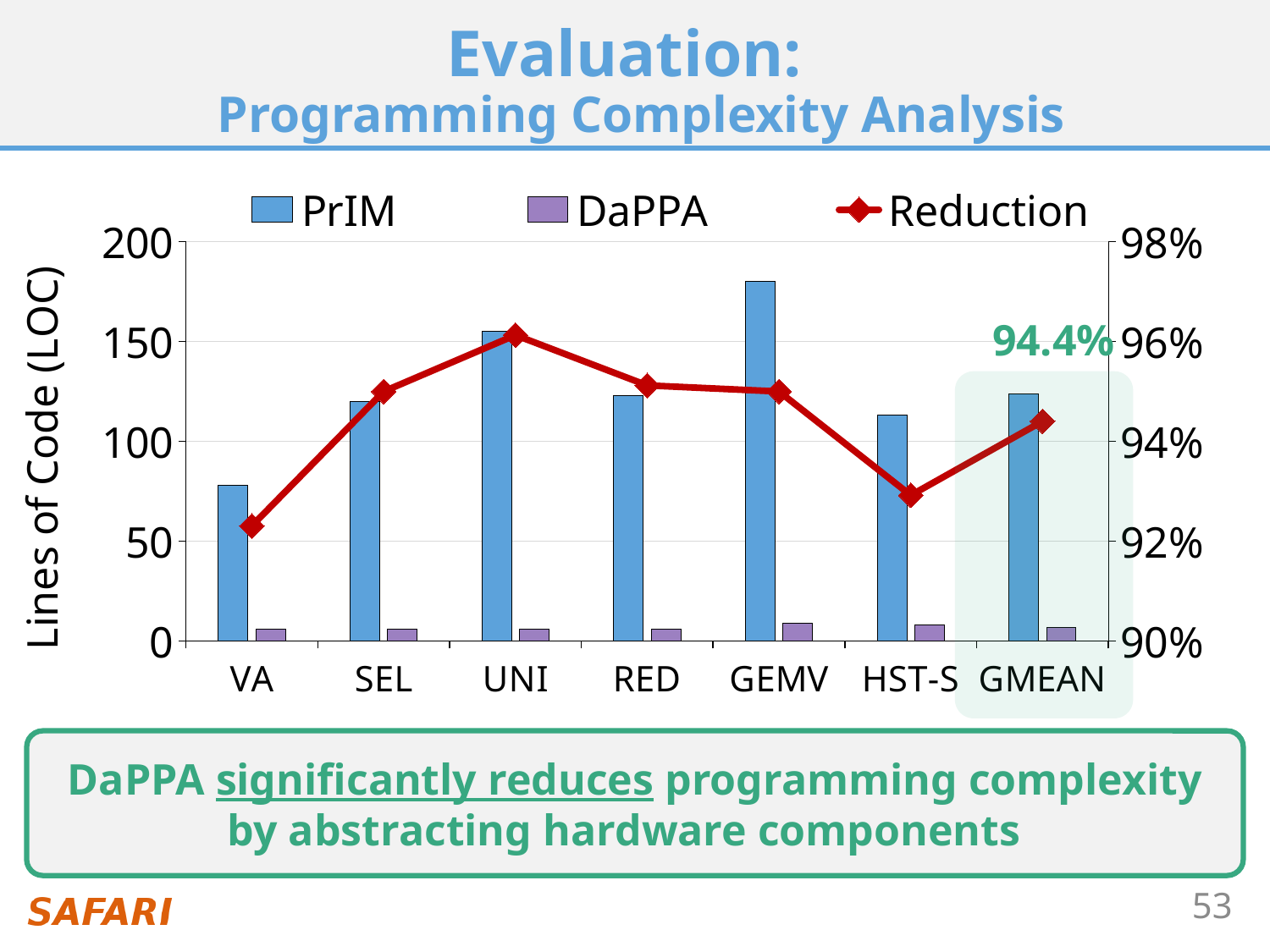
Which has more PrIM lines of code, GEMV or HST-S? GEMV Is the PrIM value for GEMV greater or less than 150? greater What is the Reduction value shown for GMEAN? 94.4% Which category has the lowest Reduction value? VA How many categories are shown on the x axis? 7 Which category has the lowest PrIM lines of code? VA Which category has the highest Reduction value? UNI Which category has the highest PrIM lines of code? GEMV Is the PrIM value for VA greater or less than 100? less Is the Reduction value for HST-S greater or less than 94%? less How many series does the legend list? 3 What is the label of the left vertical axis? Lines of Code (LOC)